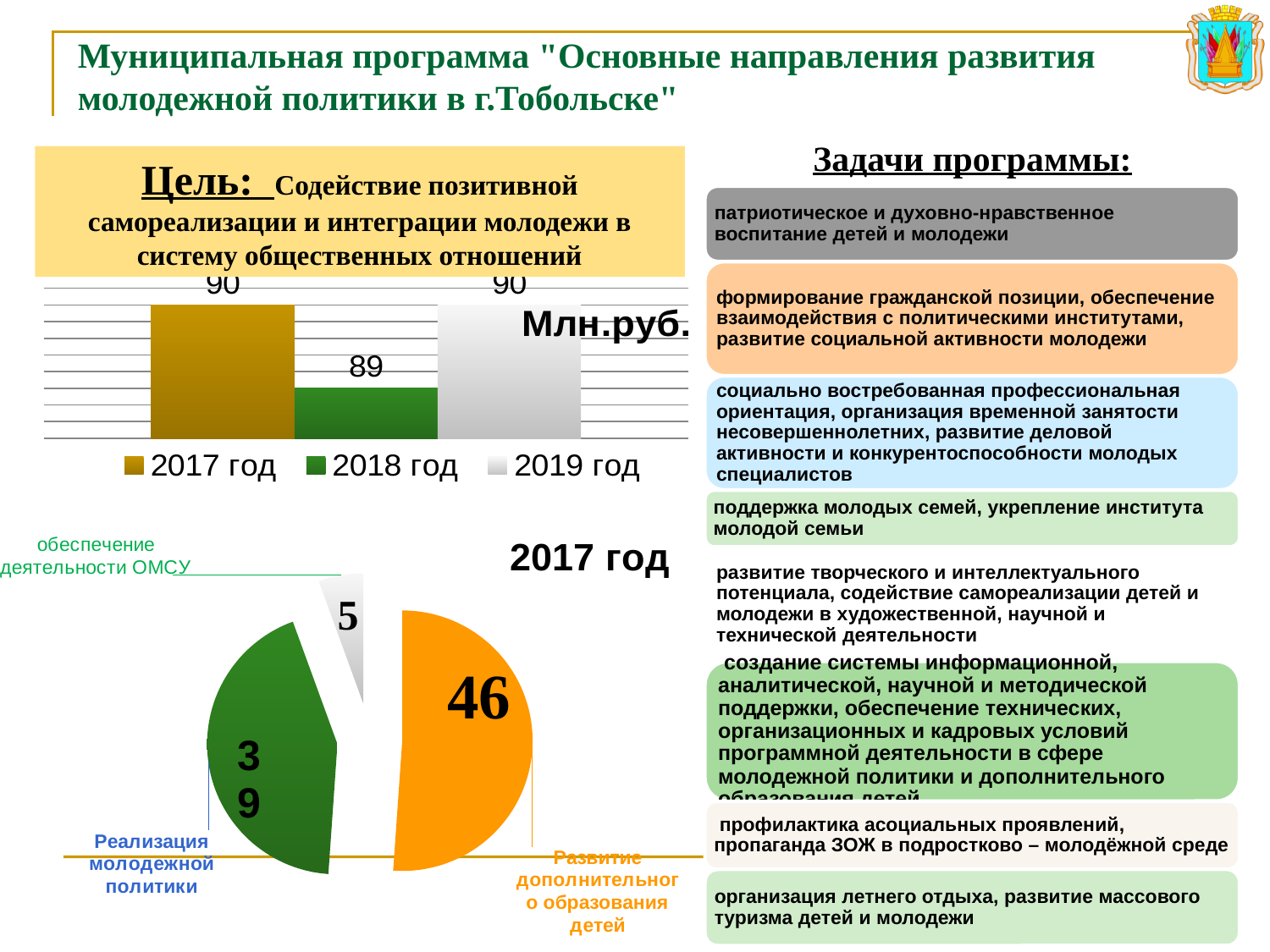
What kind of chart is the chart at the top left of the slide? bar chart In the bar chart at the top left, what unit label is shown next to the bars? Млн.руб. In the bar chart at the top left, which year has the lowest value? 2018 год In the pie chart titled 2017 год, what is the difference between the values for Развитие дополнительного образования детей and Реализация молодежной политики? 7 In the bar chart at the top left, how many entries does the legend list? 3 In the bar chart at the top left, what is the value for 2017 год? 90 In the pie chart titled 2017 год, how many slices are there? 3 In the bar chart at the top left, what is the value for 2018 год? 89 In the pie chart titled 2017 год, which slice is the largest? Развитие дополнительного образования детей In the bar chart at the top left, what is the difference between the values for 2017 год and 2018 год? 1 In the pie chart titled 2017 год, what is the value for Реализация молодежной политики? 39 In the pie chart titled 2017 год, which slice is the smallest? обеспечение деятельности ОМСУ